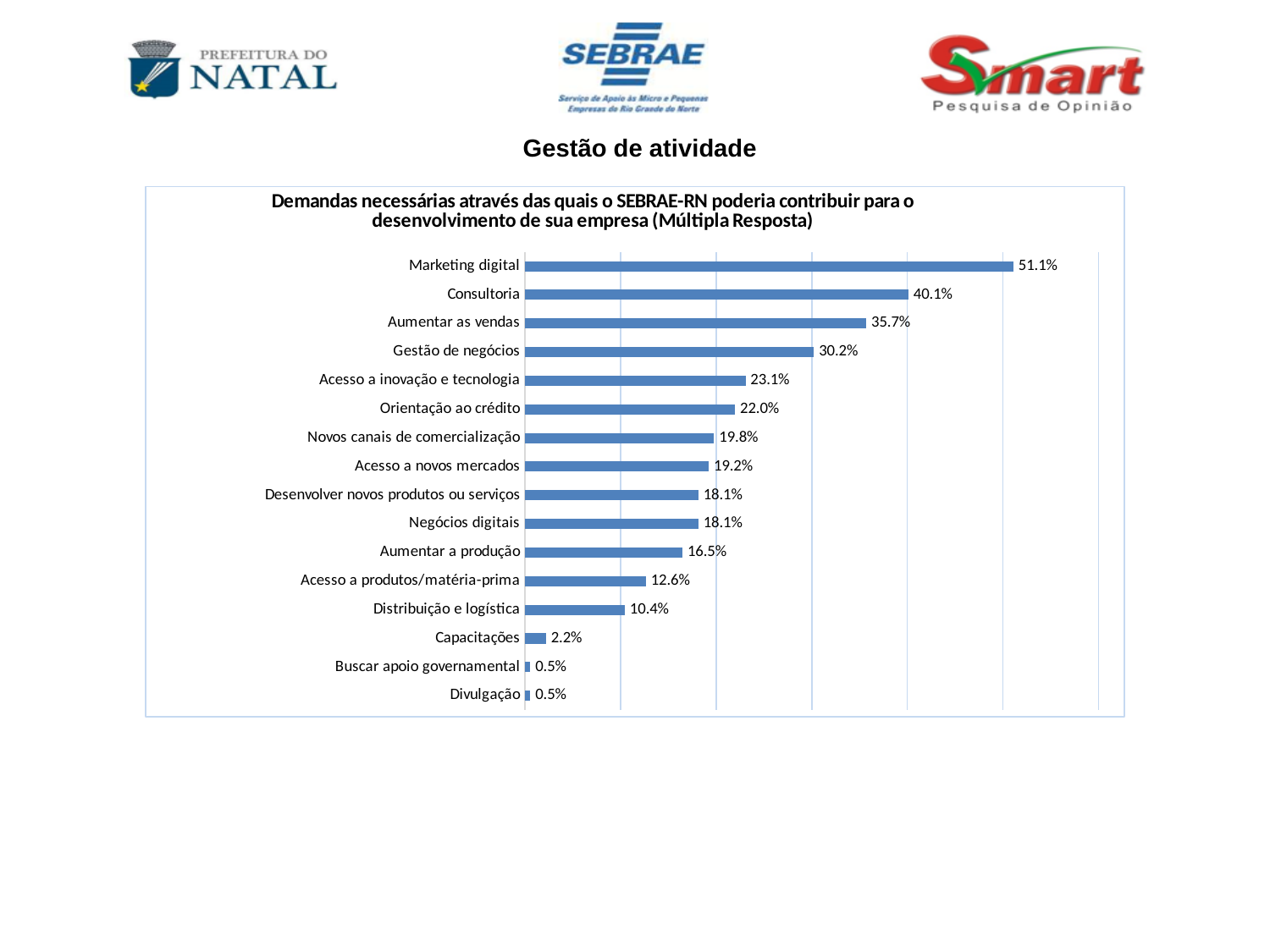
Which is larger, Acesso a inovação e tecnologia or Novos canais de comercialização? Acesso a inovação e tecnologia What is the difference between Consultoria and Aumentar as vendas? 4.4% Which category has the highest value? Marketing digital Which two categories both have a value of 18.1%? Desenvolver novos produtos ou serviços and Negócios digitais What is the value for Orientação ao crédito? 22.0% What is the difference between Marketing digital and Gestão de negócios? 20.9% Which category has the lowest value, Capacitações or Divulgação? Divulgação What is the value for Distribuição e logística? 10.4% How many categories are shown in the chart? 16 What is the title of the slide above the chart? Gestão de atividade What is the value for Marketing digital? 51.1% What kind of chart is shown on the slide? Bar chart